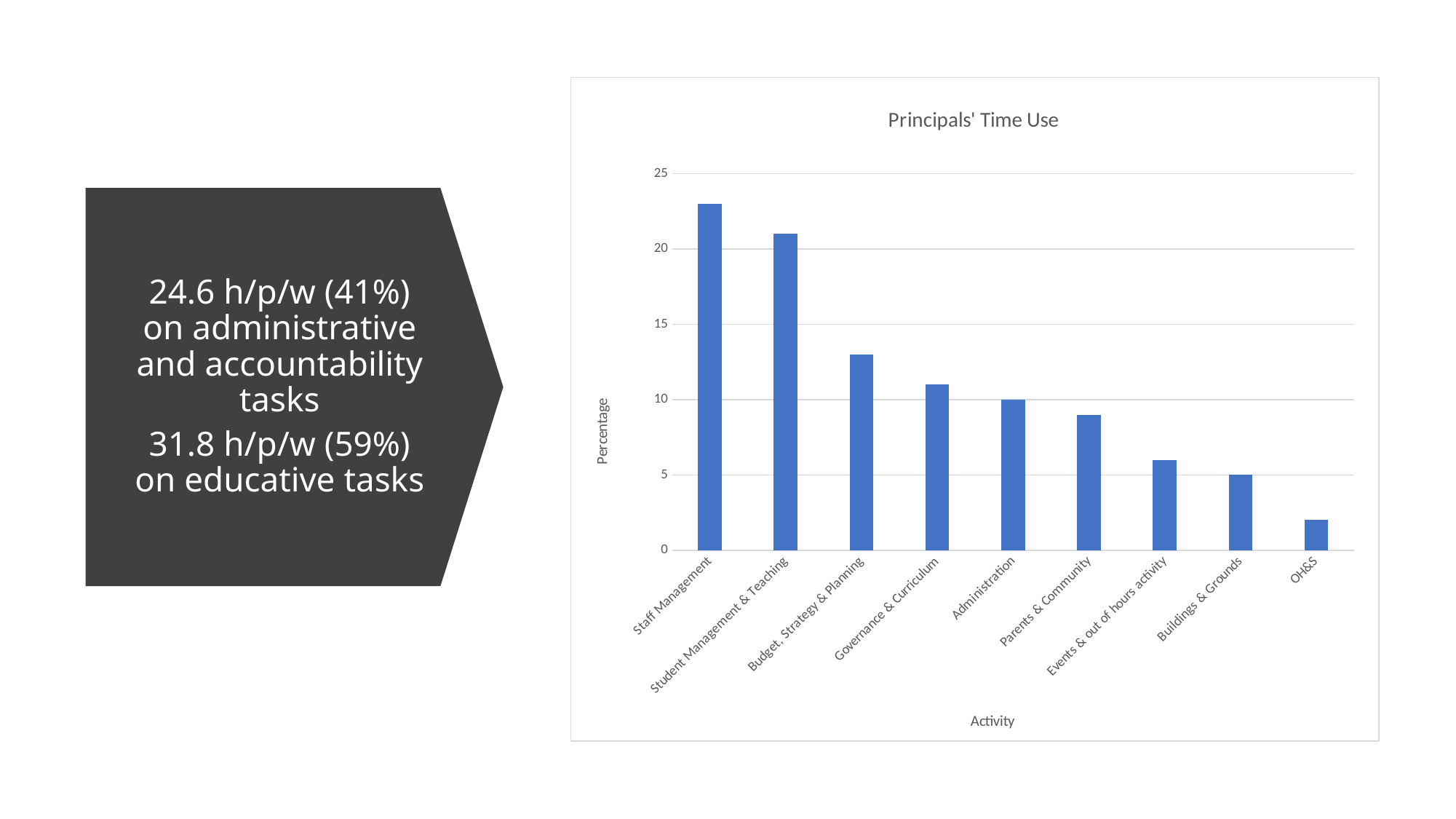
How many activity categories are plotted in the chart? 9 What is the percentage for Buildings & Grounds? 5 Is the value for Events & out of hours activity greater or less than 5? greater Do the values rise or fall moving from left to right along the x axis? fall Is the value for Staff Management greater or less than 20? greater Is the value for Budget, Strategy & Planning greater or less than 15? less What type of chart is shown on the slide? bar chart Which activity has the highest percentage? Staff Management Which activity has the lowest percentage? OH&S What is the percentage for Administration? 10 Which is larger, the value for Governance & Curriculum or the value for Parents & Community? Governance & Curriculum What is the title of the chart? Principals' Time Use